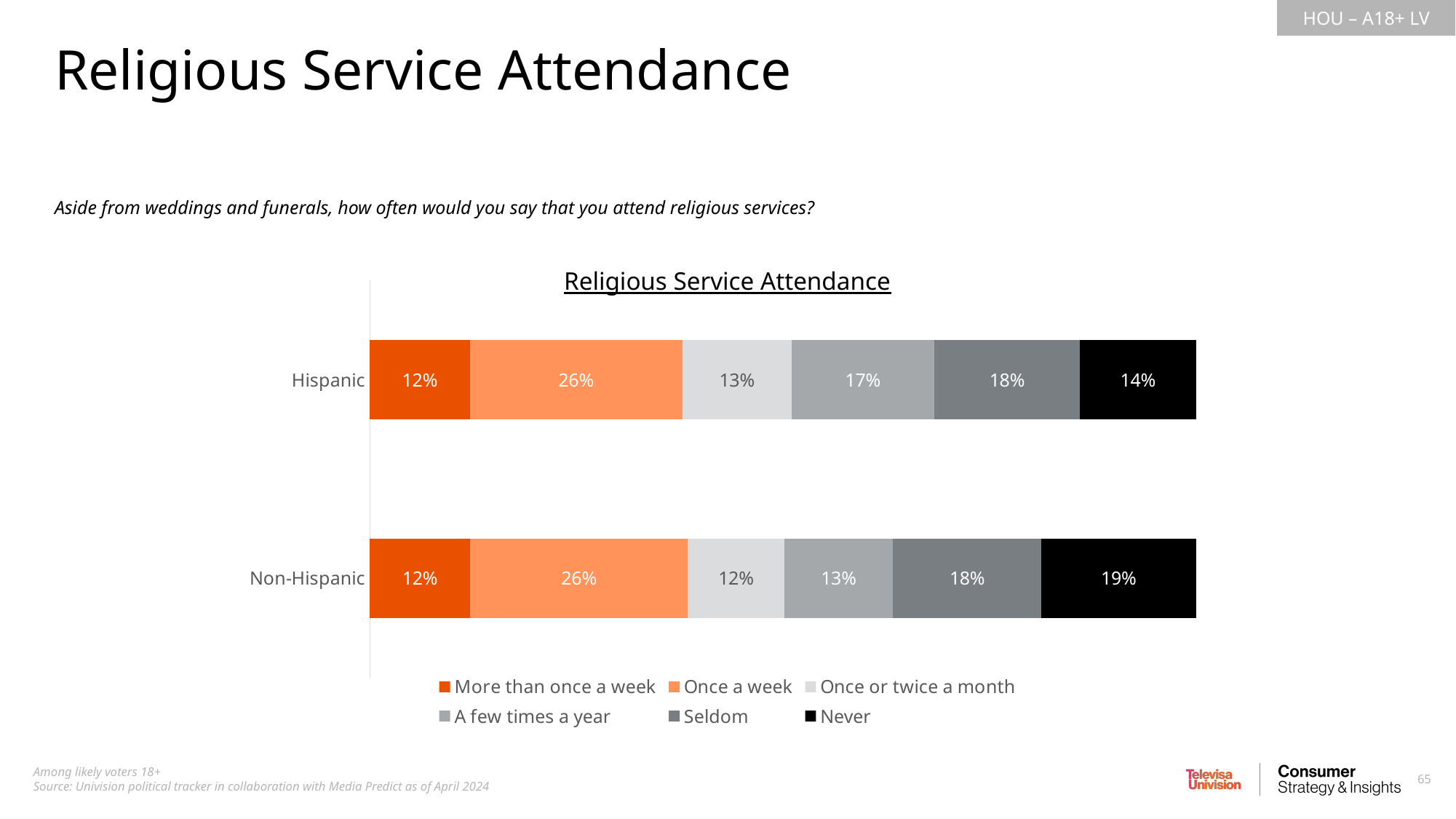
What percentage of Hispanic respondents attend religious services a few times a year? 17% What percentage of Hispanic respondents attend religious services once a week? 26% Which group has a larger share for 'A few times a year', Hispanic or Non-Hispanic? Hispanic How many series does the legend list? 6 What is the difference between the Non-Hispanic and Hispanic shares for 'Never'? 5 percentage points What percentage of Non-Hispanic respondents say they never attend religious services? 19% What colour represents the 'Never' category in the chart? Black Which attendance category has the highest share among Hispanic respondents? Once a week What percentage of Non-Hispanic respondents attend religious services once or twice a month? 12% What kind of chart is shown on the slide? Stacked bar chart How many groups (bars) are shown in the chart? 2 Which attendance category has the lowest share among Non-Hispanic respondents? More than once a week and Once or twice a month (both 12%)